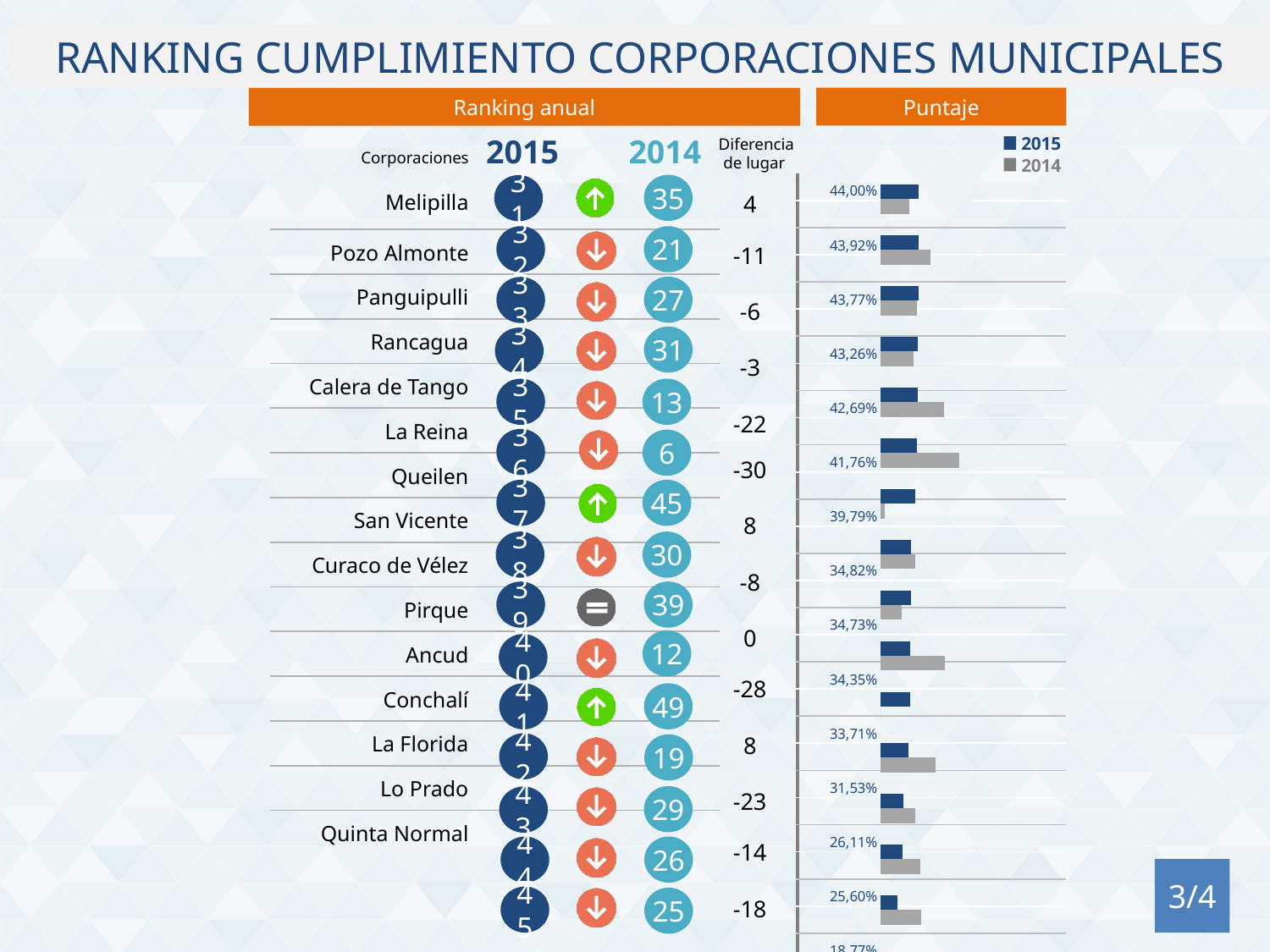
How many corporations are listed in the ranking on this slide? 15 In the "Puntaje" chart, what is the 2015 value for Melipilla? 44,00% In the "Puntaje" chart, what is the difference between the 2015 values of Melipilla and Queilen? 4,21% In the "Puntaje" chart, for Calera de Tango, which year has the larger bar, 2015 or 2014? 2014 In the "Puntaje" chart, which corporation has the highest 2015 value? Melipilla What kind of chart is shown under the "Puntaje" heading? bar chart In the "Puntaje" chart, what is the 2015 value for Pirque? 34,35% How many series does the legend of the "Puntaje" chart list? 2 Which years are listed in the legend of the "Puntaje" chart? 2015 and 2014 In the "Puntaje" chart, what is the 2015 value for Queilen? 39,79% In the "Puntaje" chart, for Queilen, which year has the larger bar, 2015 or 2014? 2015 In the "Puntaje" chart, what is the 2015 value for Pozo Almonte? 43,92%